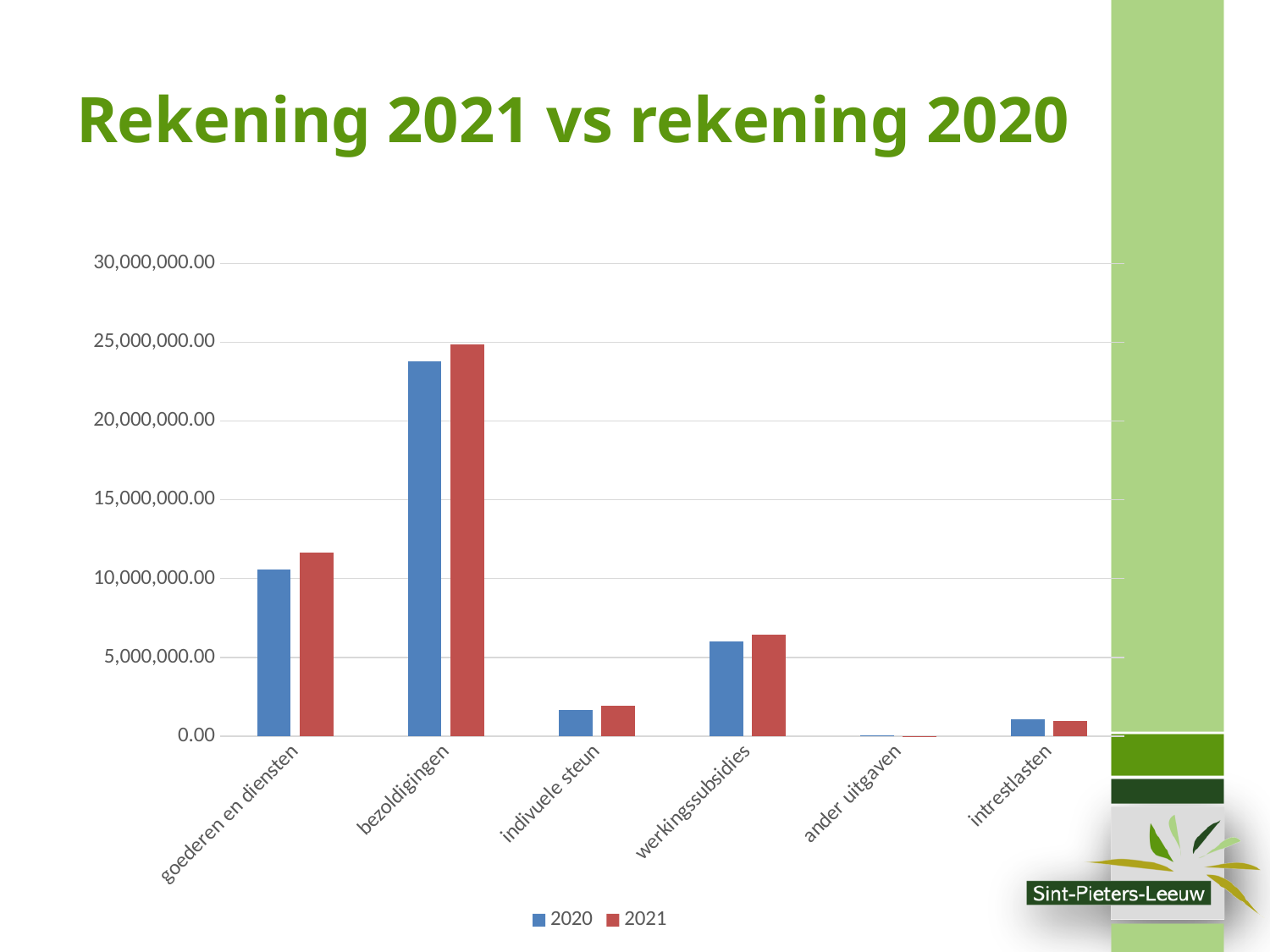
Is the 2021 value for werkingssubsidies greater or less than 5,000,000.00? greater Is the 2020 value for goederen en diensten greater or less than 15,000,000.00? less Which category has the lowest value for 2020? ander uitgaven Which category has the highest value for 2021? bezoldigingen Which is larger: the 2021 value for werkingssubsidies or the 2021 value for indivuele steun? werkingssubsidies What is the title of the slide? Rekening 2021 vs rekening 2020 Is the 2020 value for indivuele steun greater or less than 5,000,000.00? less How many series does the legend list? 2 For goederen en diensten, which series has the larger value, 2020 or 2021? 2021 What kind of chart is shown on the slide? bar chart How many categories are shown on the x axis of the chart? 6